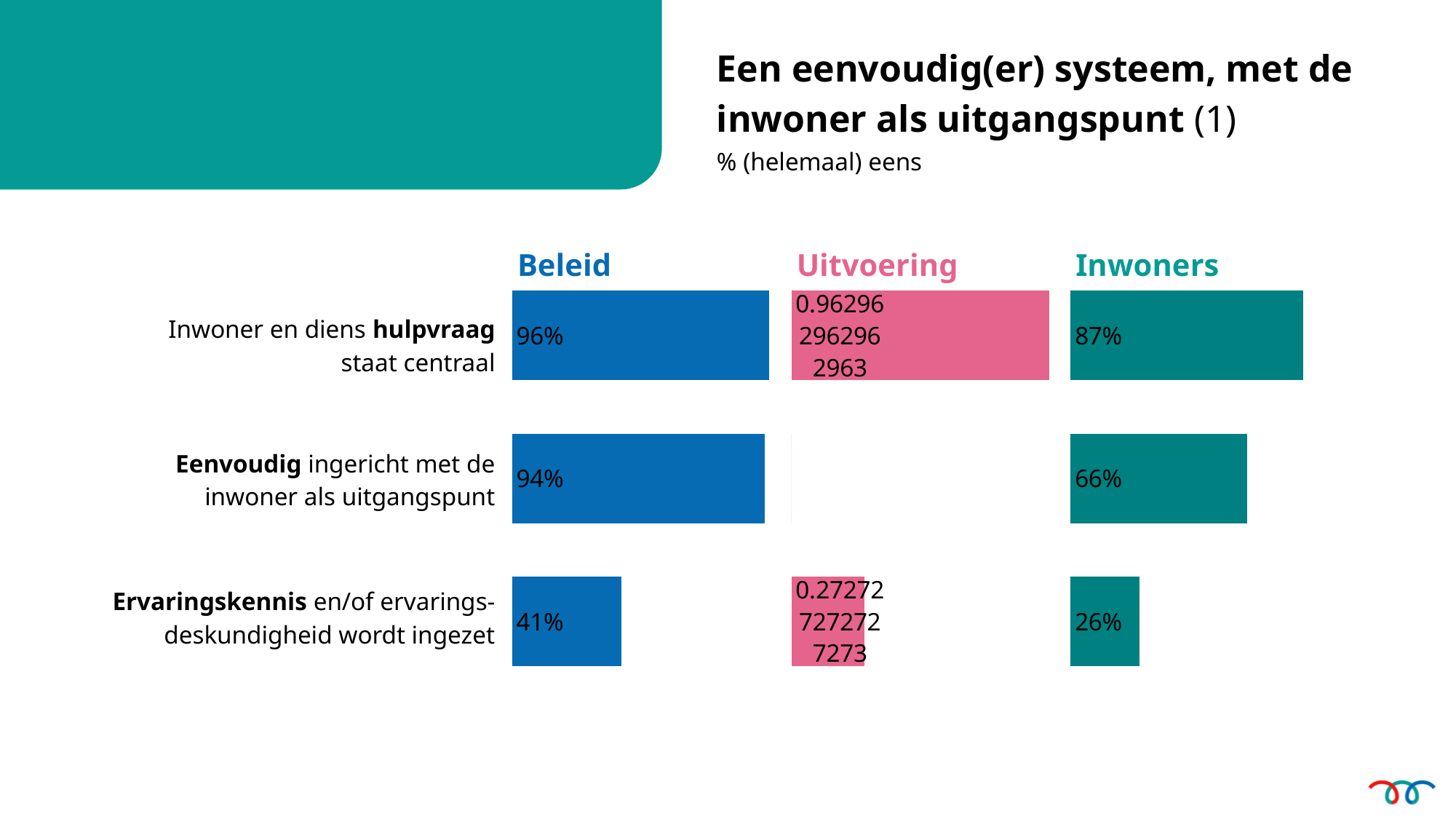
In the Beleid chart, which statement has the lowest value? Ervaringskennis en/of ervaringsdeskundigheid wordt ingezet What is the difference between the Beleid value and the Inwoners value for 'Eenvoudig ingericht met de inwoner als uitgangspunt'? 28 percentage points In the Inwoners chart, what is the value for 'Eenvoudig ingericht met de inwoner als uitgangspunt'? 66% In the Inwoners chart, which statement has the highest value? Inwoner en diens hulpvraag staat centraal In the Beleid chart, what is the value for 'Inwoner en diens hulpvraag staat centraal'? 96% In the Uitvoering chart, which bar is longer: 'Inwoner en diens hulpvraag staat centraal' or 'Ervaringskennis en/of ervaringsdeskundigheid wordt ingezet'? Inwoner en diens hulpvraag staat centraal For 'Ervaringskennis en/of ervaringsdeskundigheid wordt ingezet', which is larger: the Beleid value or the Inwoners value? Beleid In the Inwoners chart, what is the value for 'Ervaringskennis en/of ervaringsdeskundigheid wordt ingezet'? 26% In the Beleid chart, what is the value for 'Ervaringskennis en/of ervaringsdeskundigheid wordt ingezet'? 41% In the Beleid chart, what is the value for 'Eenvoudig ingericht met de inwoner als uitgangspunt'? 94% In the Inwoners chart, what is the value for 'Inwoner en diens hulpvraag staat centraal'? 87% What kind of chart is used on this slide? Bar chart